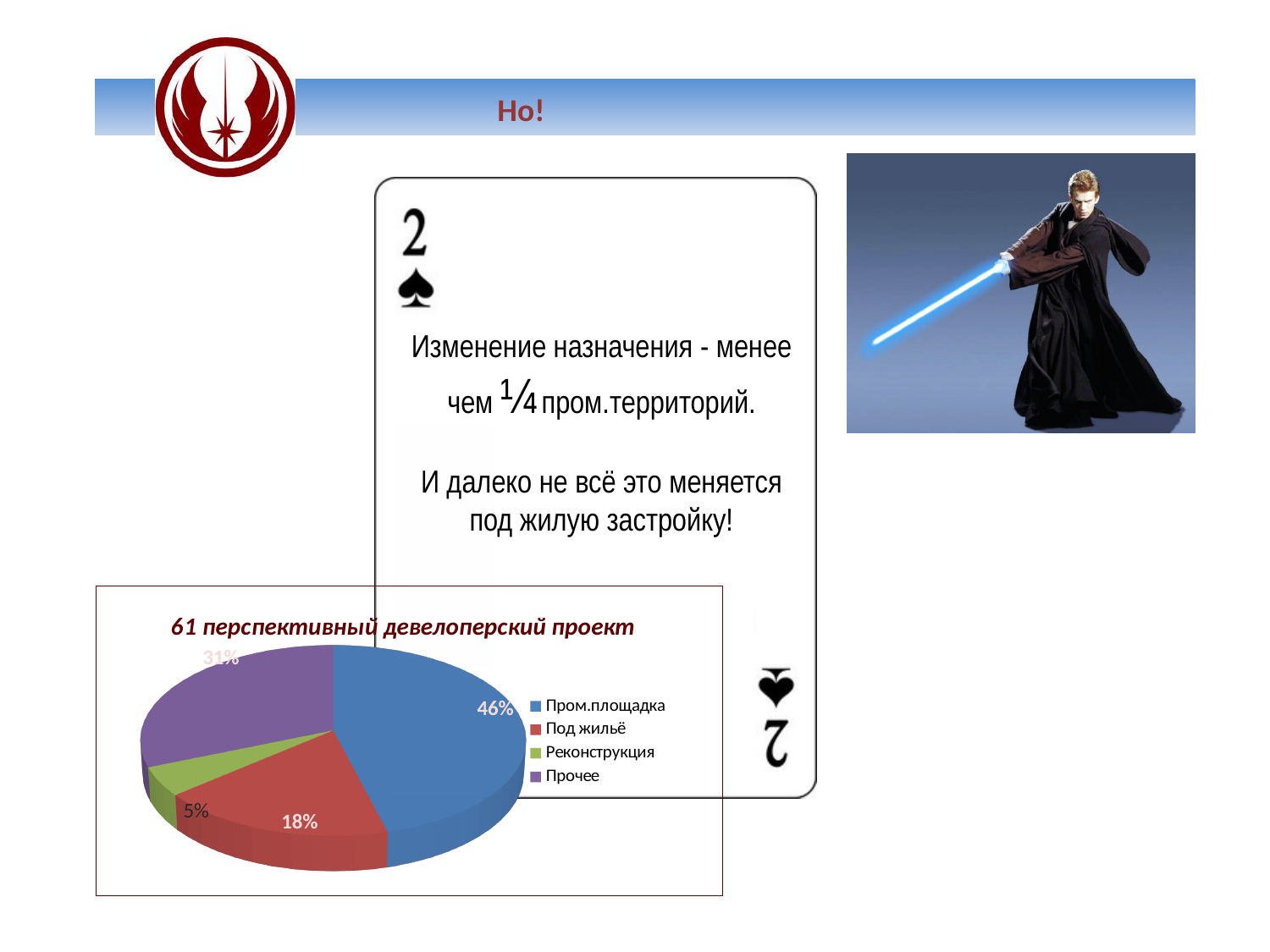
What share of the pie does Прочее have? 31% How many entries does the legend of the pie chart list? 4 Which is larger, the share for Под жильё or the share for Прочее? Прочее What share of the pie does Под жильё have? 18% What share of the pie does Реконструкция have? 5% Which category has the largest slice of the pie? Пром.площадка What kind of chart is shown on the slide? pie chart What is the title of the pie chart? 61 перспективный девелоперский проект How many slices does the pie chart have? 4 What is the difference in percentage points between Пром.площадка and Прочее? 15 Which category has the smallest slice of the pie? Реконструкция